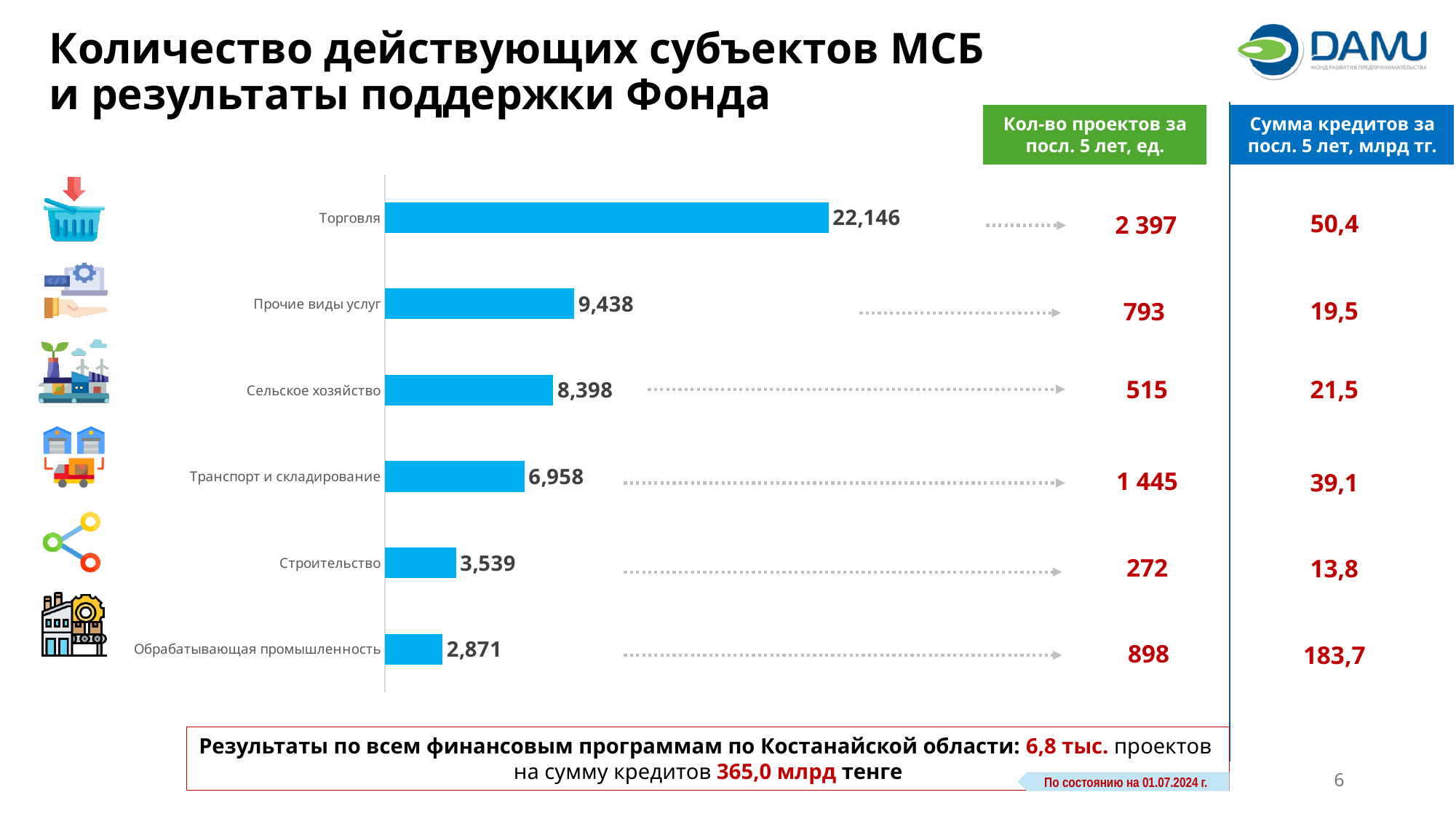
Do the bar values increase or decrease going from the top category to the bottom category? Decrease What is the difference between the values for Торговля and Прочие виды услуг? 12,708 Which category has the lowest value in the bar chart? Обрабатывающая промышленность What is the difference between the values for Строительство and Обрабатывающая промышленность? 668 What is the value shown for Сельское хозяйство in the bar chart? 8,398 Which is larger: the value for Прочие виды услуг or the value for Сельское хозяйство? Прочие виды услуг Which category has the highest value in the bar chart? Торговля How many categories are shown in the bar chart? 6 What kind of chart is shown on the slide? Bar chart What is the value shown for Транспорт и складирование in the bar chart? 6,958 What is the value shown for Торговля in the bar chart? 22,146 What is the value shown for Обрабатывающая промышленность in the bar chart? 2,871